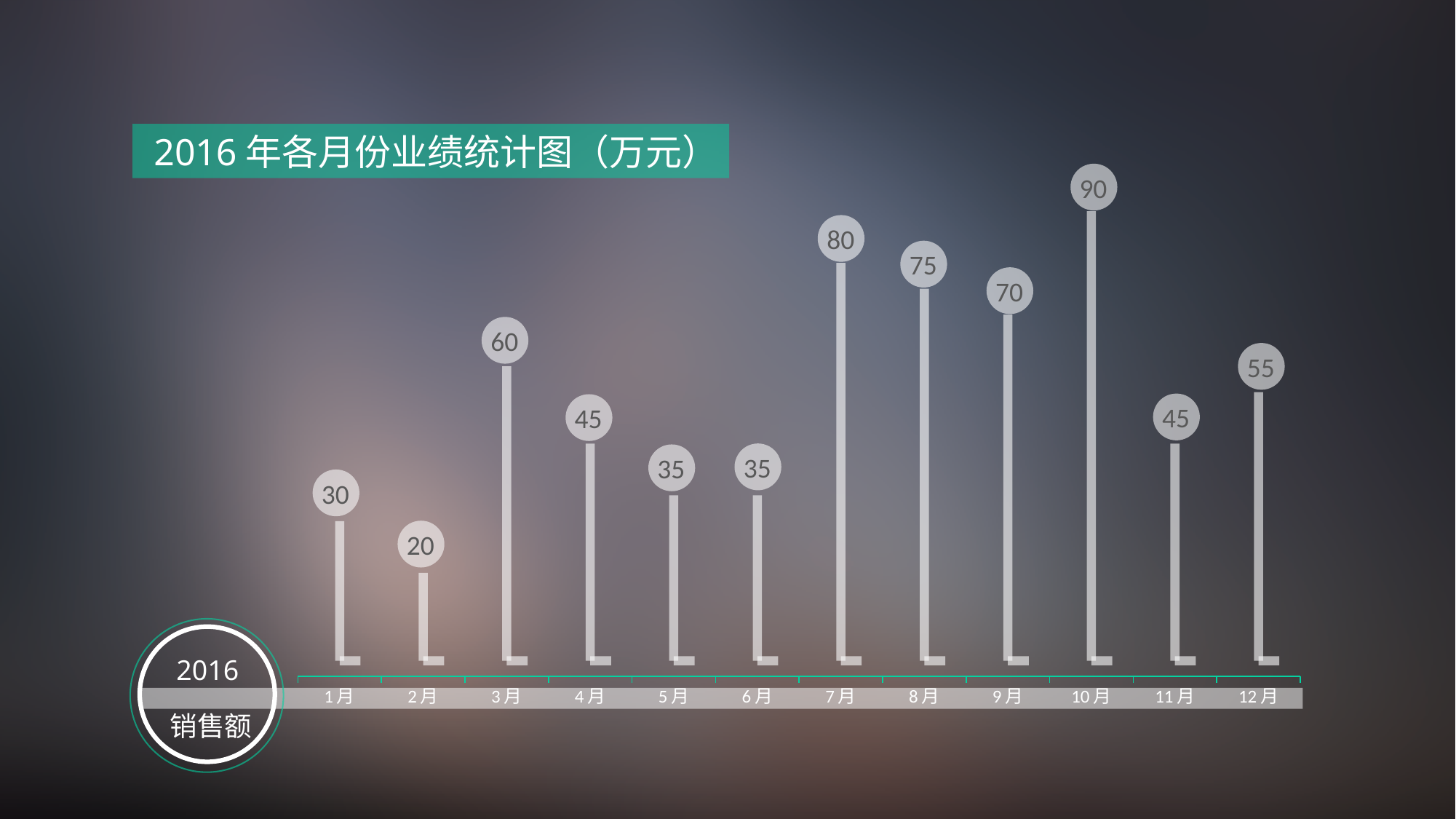
What is the difference between the values for 3月 and 4月? 15 Which is larger, the value for 8月 or the value for 9月? 8月 How many months are shown on the x axis? 12 What is the value for 7月? 80 Which month has the lowest value? 2月 Which month has the highest value? 10月 What kind of chart is shown on the slide? bar chart What is the value for 2月? 20 What is the title of the chart? 2016 年各月份业绩统计图（万元） What is the difference between the values for 10月 and 2月? 70 Which is larger, the value for 12月 or the value for 11月? 12月 What is the value for 10月? 90